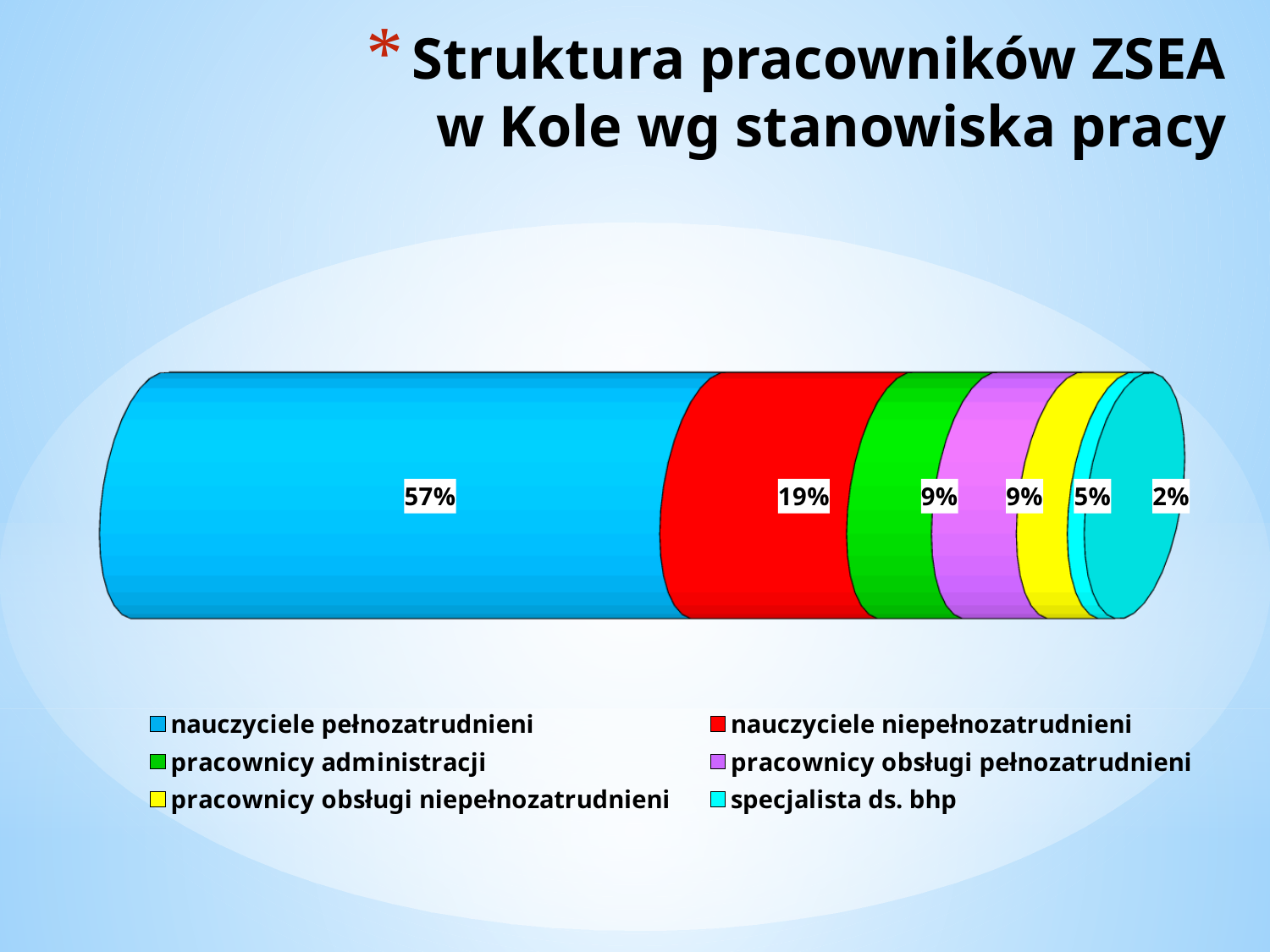
What percentage of employees are specjalista ds. bhp? 2% How many categories does the legend list? 6 What percentage of employees are nauczyciele pełnozatrudnieni? 57% What colour represents pracownicy obsługi pełnozatrudnieni in the chart? purple What is the difference in percentage points between nauczyciele pełnozatrudnieni and nauczyciele niepełnozatrudnieni? 38 What percentage of employees are pracownicy obsługi niepełnozatrudnieni? 5% Which category has the smallest share of employees? specjalista ds. bhp Which category has the largest share of employees? nauczyciele pełnozatrudnieni What percentage of employees are pracownicy administracji? 9% What percentage of employees are nauczyciele niepełnozatrudnieni? 19% Which is larger: the share of pracownicy obsługi niepełnozatrudnieni or the share of specjalista ds. bhp? pracownicy obsługi niepełnozatrudnieni What kind of chart is shown on the slide? stacked bar chart